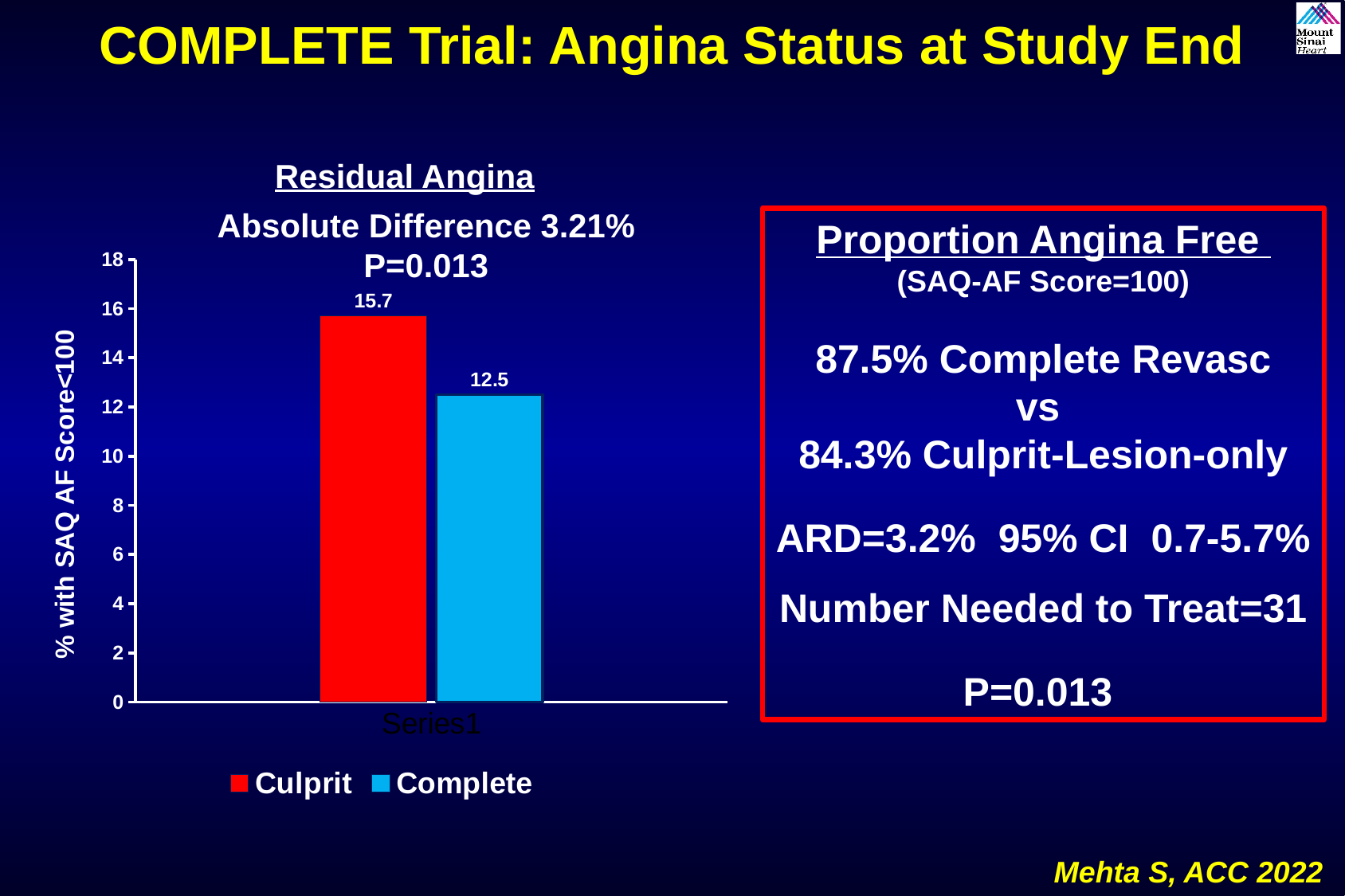
Which series has the lowest value in the Residual Angina chart? Complete Is the value for Culprit greater or less than 14 in the Residual Angina chart? greater What kind of chart is shown on the slide? Bar chart What is the difference between the Culprit and Complete values in the Residual Angina chart? 3.2 What colour is the Complete bar in the Residual Angina chart? Blue Which series has the higher value in the Residual Angina chart, Culprit or Complete? Culprit How many series does the legend list in the Residual Angina chart? 2 What is the value for Culprit in the Residual Angina chart? 15.7 What is the y-axis label of the Residual Angina chart? % with SAQ AF Score<100 What is the maximum value shown on the y-axis of the Residual Angina chart? 18 What is the value for Complete in the Residual Angina chart? 12.5 Is the value for Complete greater or less than 14 in the Residual Angina chart? less